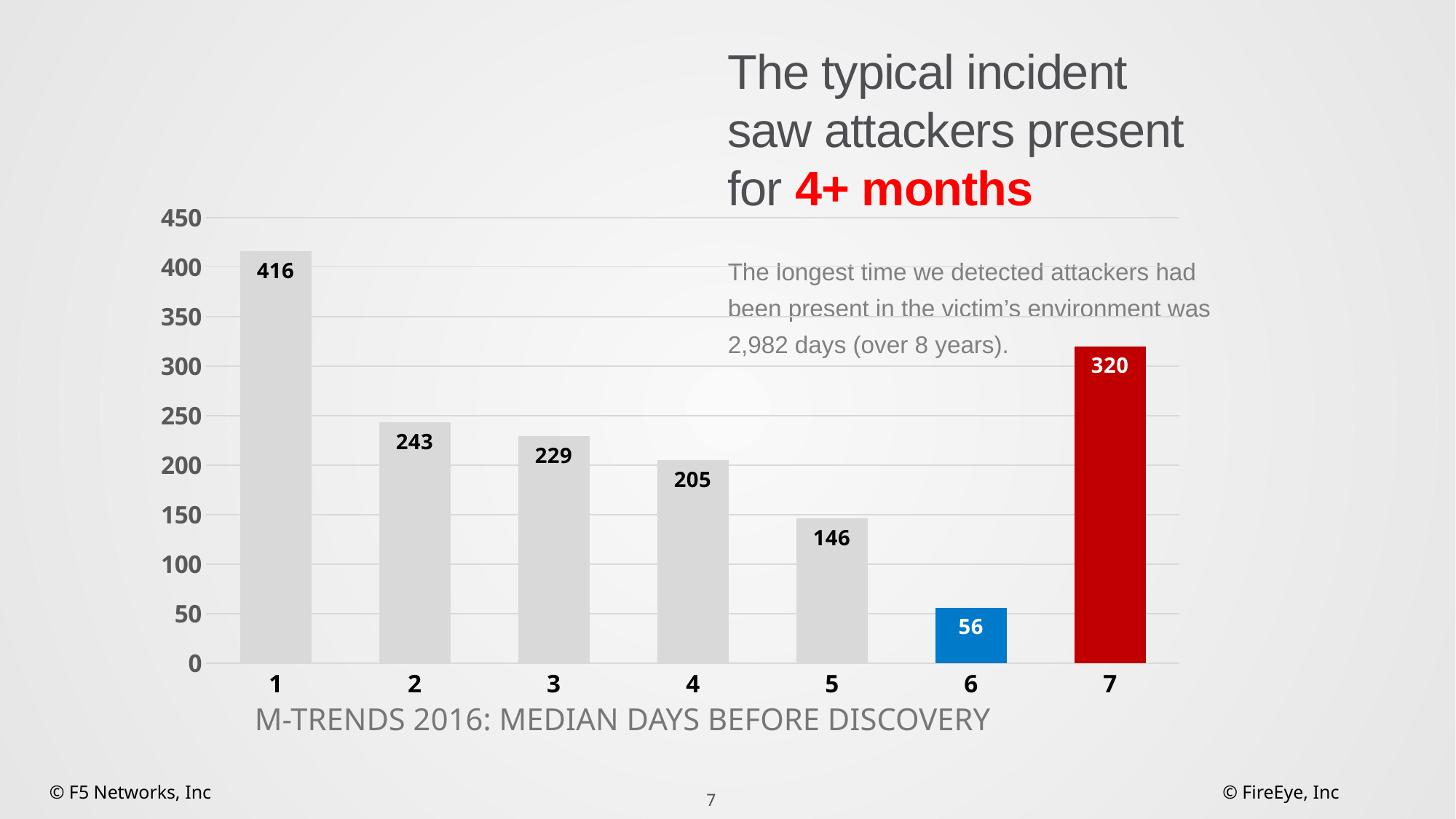
What is the value for category 7? 320 What colour is the bar for category 7? red What is the value for category 1? 416 Which category has the highest value? 1 What is the difference between the values for category 2 and category 3? 14 What is the value for category 6? 56 How many bars are shown in the chart? 7 What kind of chart is shown on the slide? bar chart Which category has the lowest value? 6 Is the value for category 5 greater or less than 150? less What is the difference between the values for category 1 and category 7? 96 Which is larger, the value for category 4 or the value for category 5? 4